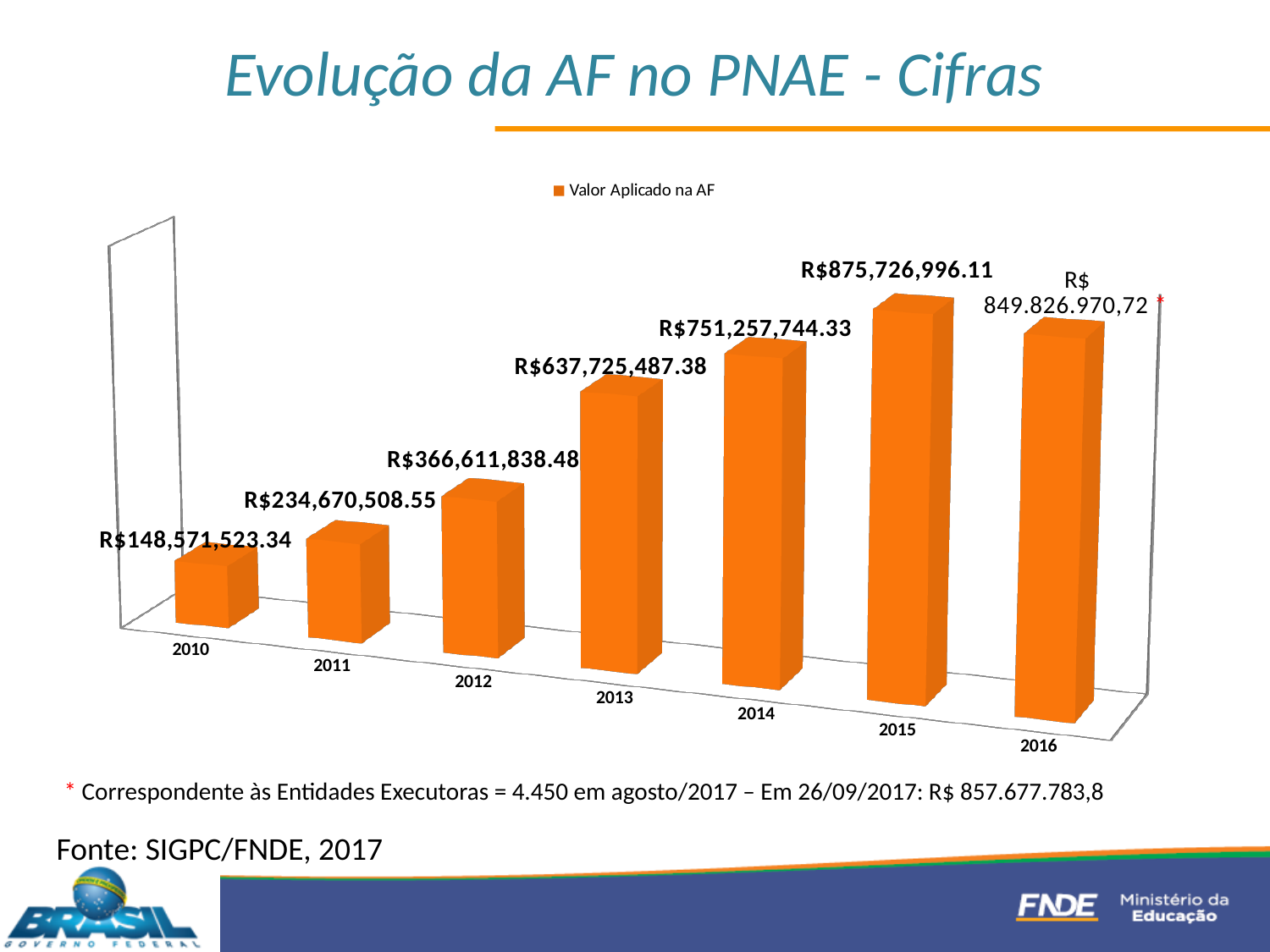
Do the values rise or fall from 2010 to 2015? Rise Which year has the lowest value? 2010 What is the difference between the values for 2011 and 2010? R$86,098,985.21 What is the value for 2010? R$148,571,523.34 What is the value for 2013? R$637,725,487.38 How many years are shown on the chart? 7 Which is larger, the value for 2015 or the value for 2016? 2015 Which year has the highest value? 2015 How many series does the legend list? 1 What is the difference between the values for 2015 and 2014? R$124,469,251.78 What is the value for 2016? R$ 849.826.970,72 What kind of chart is shown? Bar chart